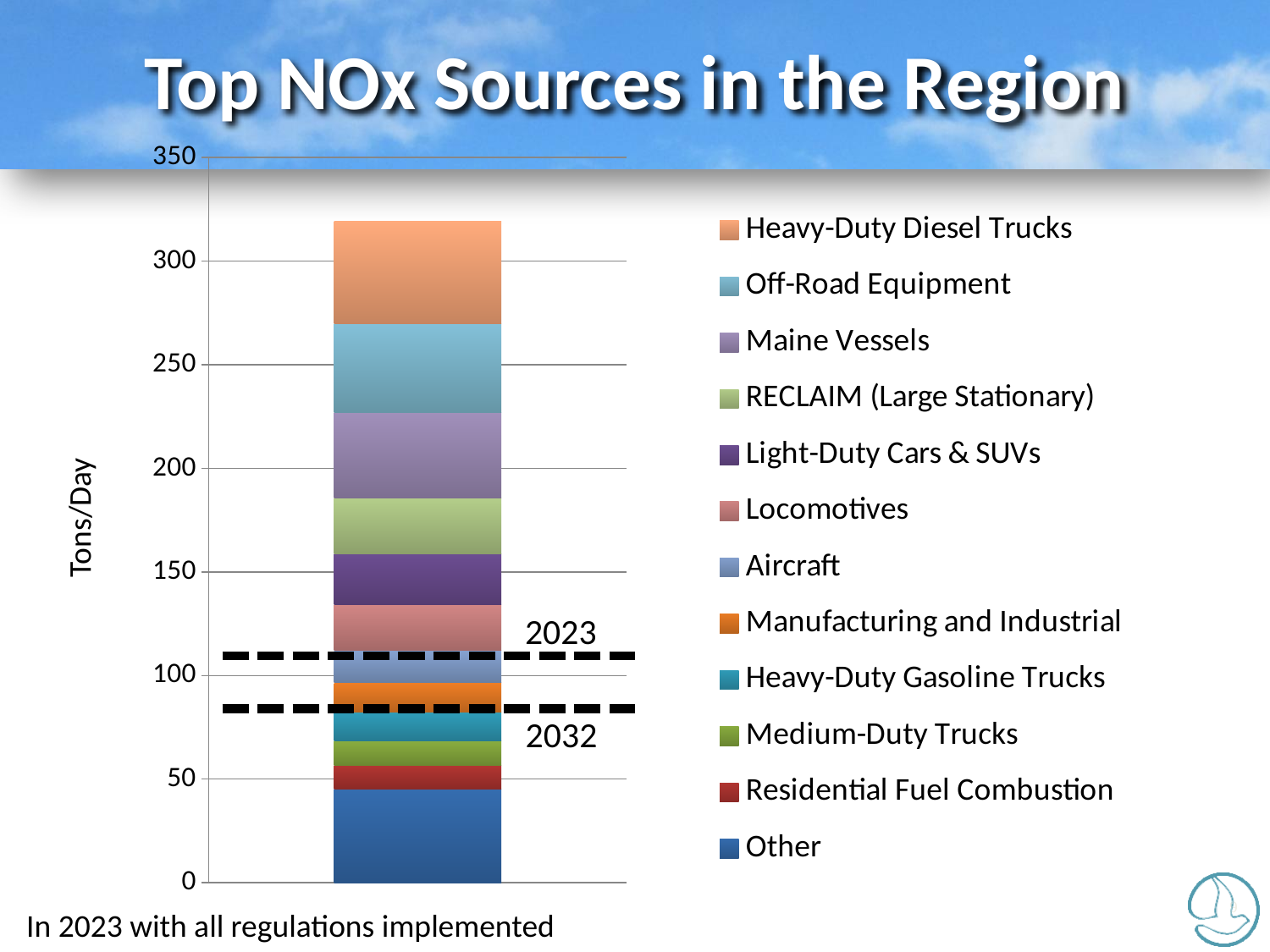
Is the dashed line labeled 2023 greater or less than 100 Tons/Day? greater Which source forms the topmost segment of the stacked bar? Heavy-Duty Diesel Trucks Which source forms the bottom segment of the stacked bar? Other Which segment is larger, Heavy-Duty Diesel Trucks or Aircraft? Heavy-Duty Diesel Trucks Is the dashed line labeled 2032 greater or less than 100 Tons/Day? less How many series does the legend list? 12 Which dashed line sits higher on the chart, 2023 or 2032? 2023 What kind of chart is shown on the slide? Stacked bar chart Is the total height of the stacked bar greater or less than 300? greater Which segment is larger, Maine Vessels or Residential Fuel Combustion? Maine Vessels What is the label on the vertical axis? Tons/Day What is the title of the chart? Top NOx Sources in the Region